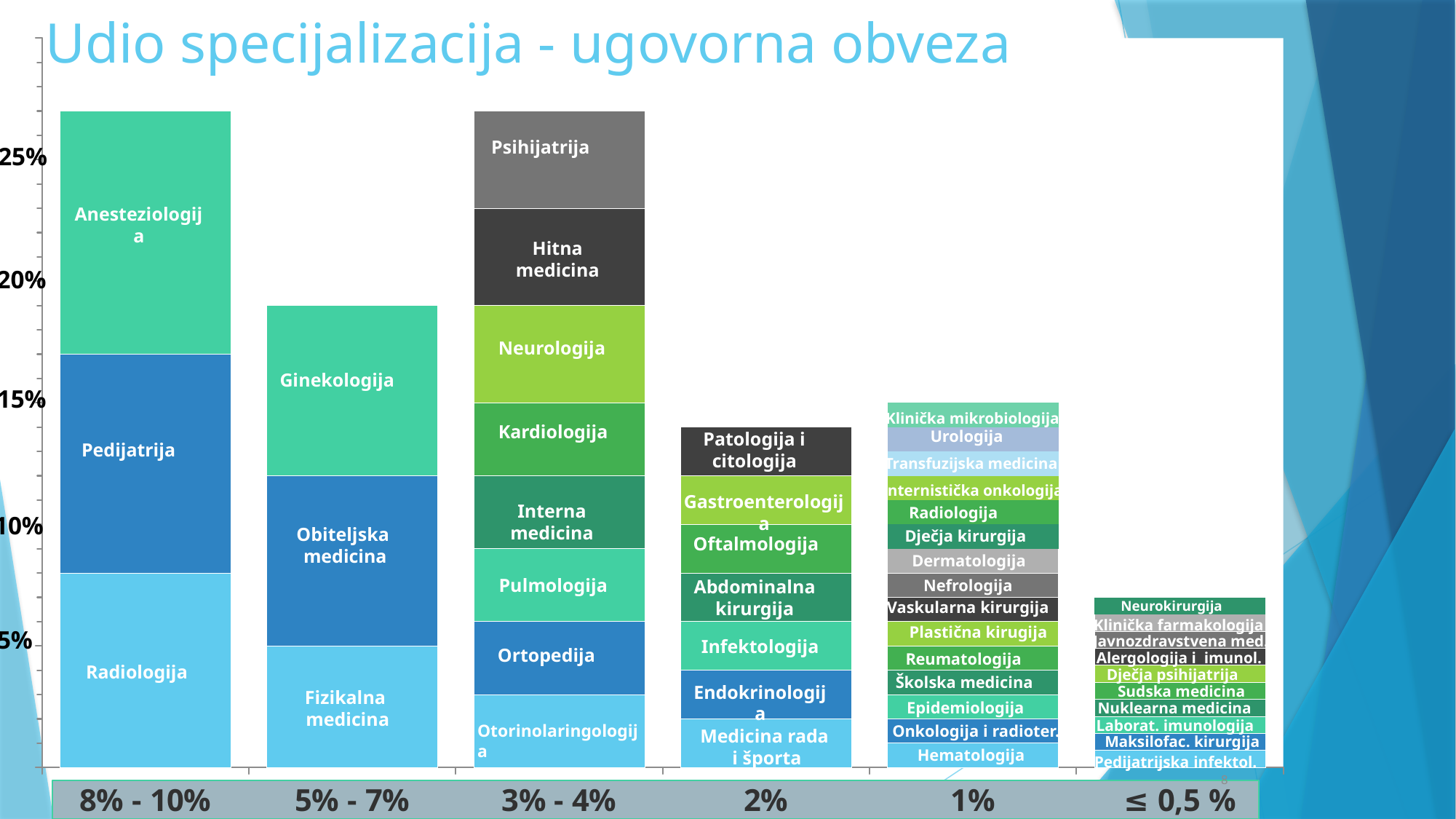
How many categories are shown along the x axis? 6 What kind of chart is shown on the slide? stacked bar chart Which segment is at the top of the bar for "3% - 4%"? Psihijatrija Which bar is taller, "1%" or "≤ 0,5 %"? 1% Is the total height of the bar for "8% - 10%" greater or less than 25%? greater Which category has the shortest stacked bar? ≤ 0,5 % Is the total height of the bar for "5% - 7%" greater or less than 20%? less How many segments make up the bar for "8% - 10%"? 3 Is the total height of the bar for "2%" greater or less than 15%? less Which bar is taller, "5% - 7%" or "2%"? 5% - 7% What is the title of the chart? Udio specijalizacija - ugovorna obveza